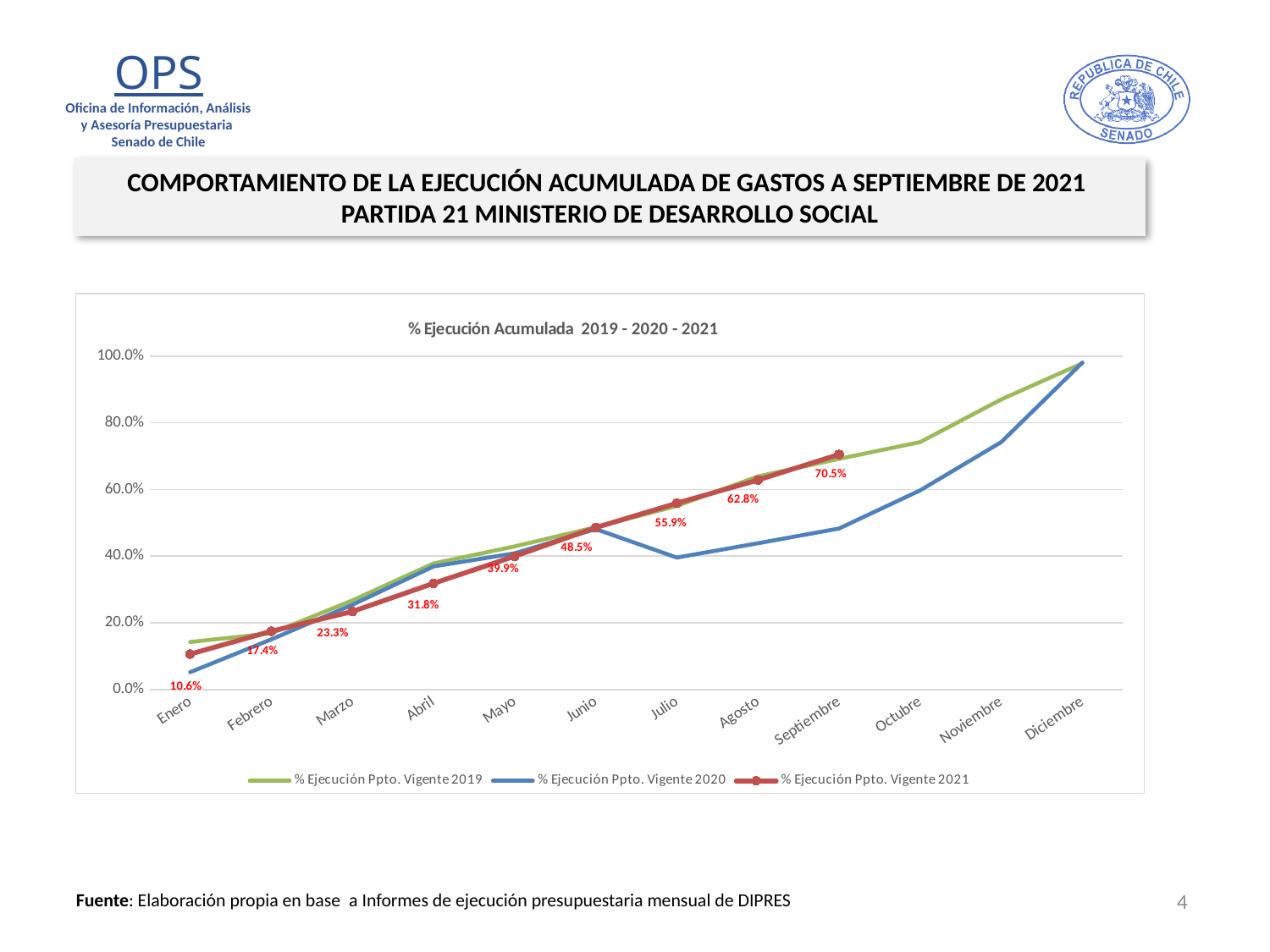
Is the value of % Ejecución Ppto. Vigente 2020 for Julio greater or less than 60.0%? less Which month has the highest value for % Ejecución Ppto. Vigente 2021? Septiembre What is the value of % Ejecución Ppto. Vigente 2021 for Julio? 55.9% What kind of chart is shown on the slide? Line chart What is the value of % Ejecución Ppto. Vigente 2021 for Septiembre? 70.5% What is the value of % Ejecución Ppto. Vigente 2021 for Enero? 10.6% How many series does the legend list? 3 Which is larger in Agosto: % Ejecución Ppto. Vigente 2021 or % Ejecución Ppto. Vigente 2020? % Ejecución Ppto. Vigente 2021 What is the difference between the 2021 values for Septiembre and Agosto? 7.7% Which month has the lowest value for % Ejecución Ppto. Vigente 2021? Enero What is the value of % Ejecución Ppto. Vigente 2021 for Mayo? 39.9% What is the difference between the 2021 values for Junio and Enero? 37.9%